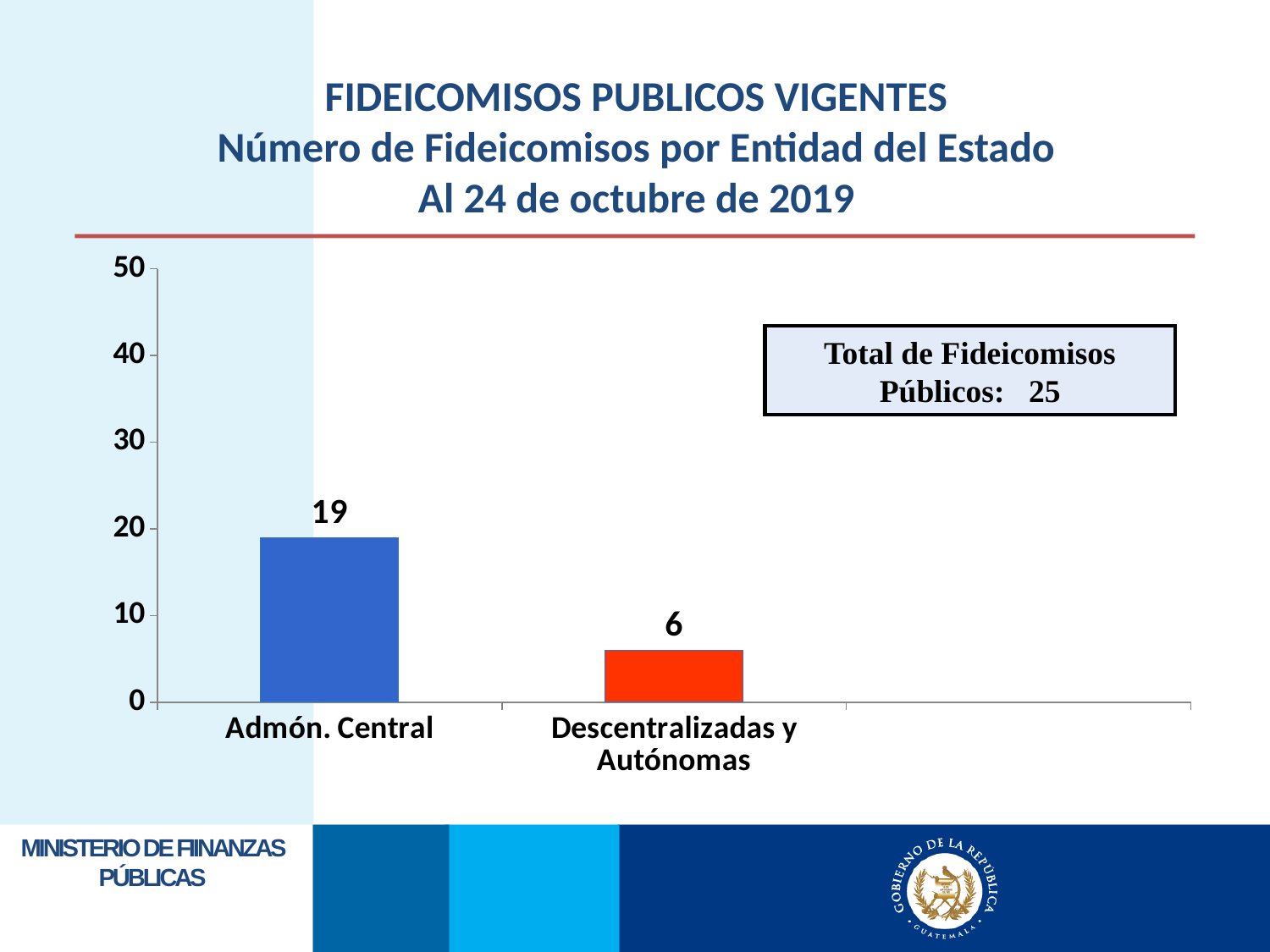
Which is larger, the value for Admón. Central or the value for Descentralizadas y Autónomas? Admón. Central What kind of chart is shown on the slide? bar chart What is the value for Admón. Central? 19 Which category has the highest value? Admón. Central What is the difference between the values for Admón. Central and Descentralizadas y Autónomas? 13 Is the value for Admón. Central greater or less than 20? less Is the value for Descentralizadas y Autónomas greater or less than 10? less Which category has the lowest value? Descentralizadas y Autónomas How many categories are shown on the x axis? 2 What colour is the bar for Descentralizadas y Autónomas? red What total number of public trusts (Total de Fideicomisos Públicos) is stated in the box on the slide? 25 What is the value for Descentralizadas y Autónomas? 6